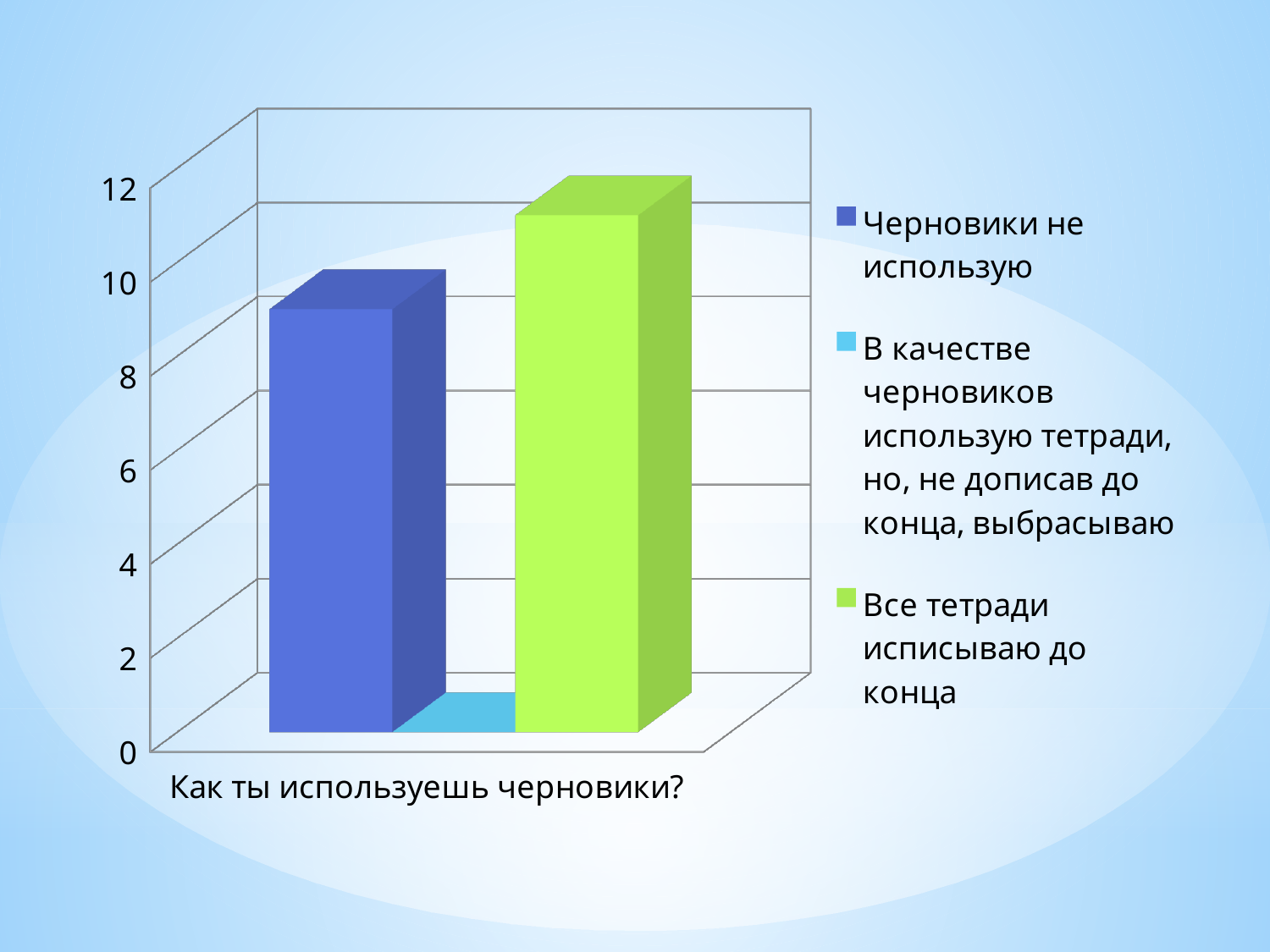
Is the value for "Черновики не использую" greater or less than 10? less How many series does the legend list? 3 What colour is the bar for "Все тетради исписываю до конца"? green What is the highest value shown on the vertical axis? 12 What is the category label shown on the x axis? Как ты используешь черновики? Is the value for "Черновики не использую" greater or less than 8? greater What kind of chart is shown on the slide? bar chart Which series has the lowest bar? В качестве черновиков использую тетради, но, не дописав до конца, выбрасываю Is the value for "Все тетради исписываю до конца" greater or less than 10? greater Which series has the highest bar? Все тетради исписываю до конца Which is larger: the bar for "Черновики не использую" or the bar for "Все тетради исписываю до конца"? Все тетради исписываю до конца